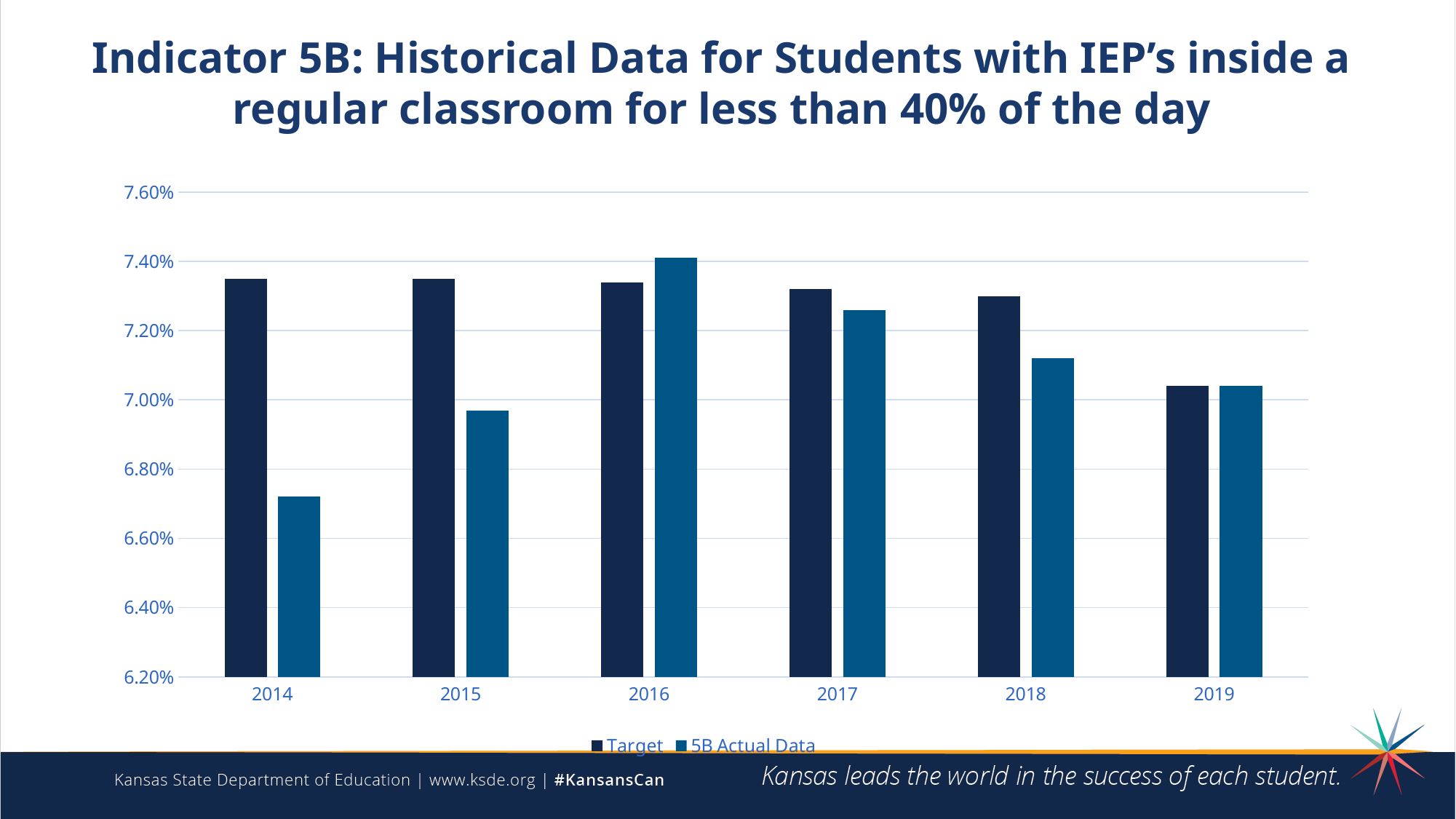
Is the Target value for 2019 greater or less than 7.20%? less In which year is the 5B Actual Data value lowest? 2014 How many series does the legend list? 2 In 2014, which is larger: the Target or the 5B Actual Data value? Target In which year is the 5B Actual Data value highest? 2016 Is the 5B Actual Data value for 2016 greater or less than 7.20%? greater In 2016, which is larger: the Target or the 5B Actual Data value? 5B Actual Data In which year is the Target value lowest? 2019 What kind of chart is shown on the slide? bar chart Is the 5B Actual Data value for 2014 greater or less than 6.80%? less How many years are shown on the x axis? 6